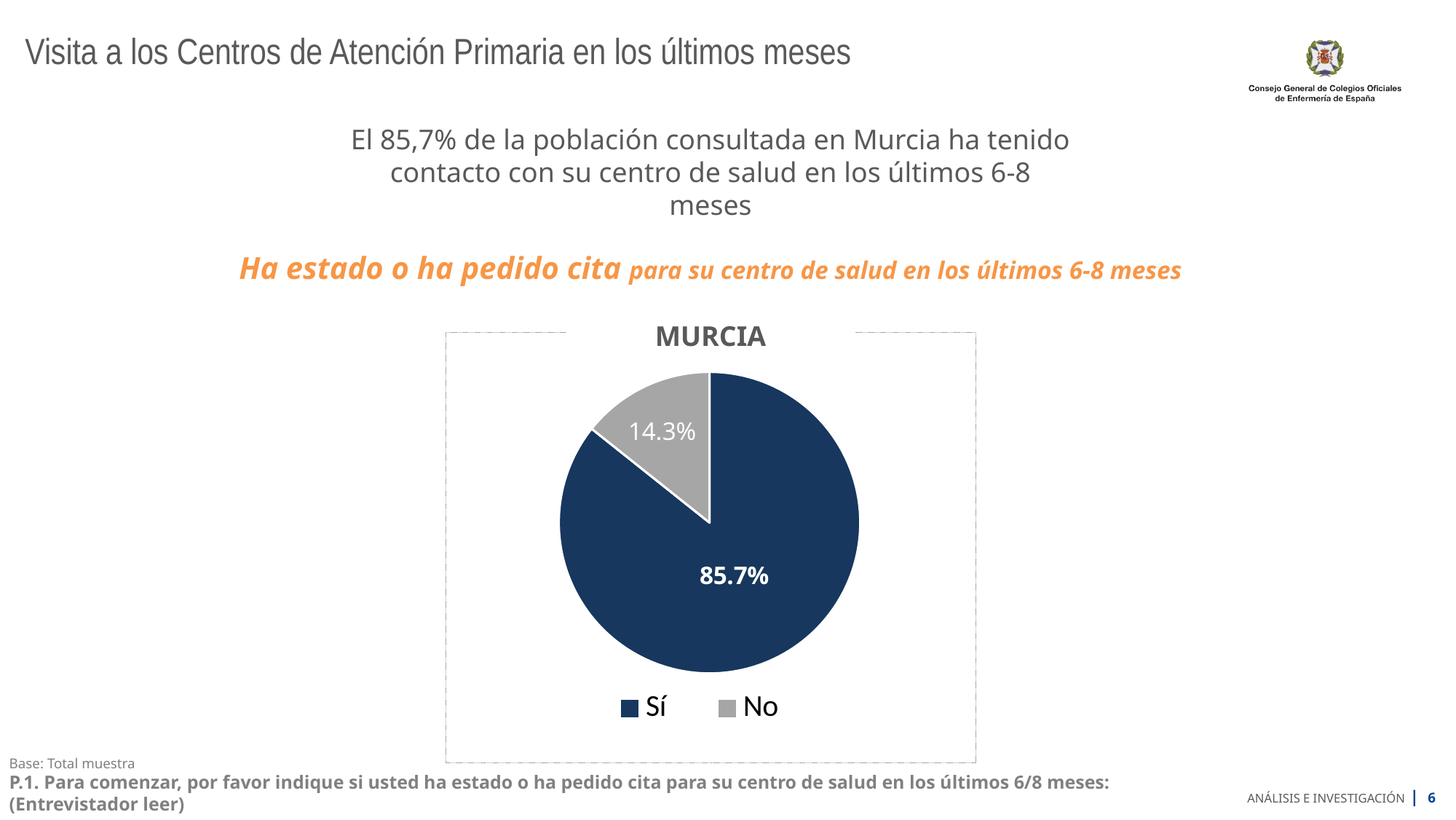
Which slice of the pie is the largest? Sí What is the difference in percentage points between the "Sí" and "No" slices? 71.4 What kind of chart is shown on the slide? Pie chart What colour is the "No" slice in the pie chart? Grey What percentage of the pie corresponds to "Sí"? 85.7% Which is larger, the "Sí" slice or the "No" slice? Sí What is the total of the two slices shown in the pie chart? 100% How many slices does the pie chart have? 2 What percentage of the pie corresponds to "No"? 14.3% What is the title of the chart? MURCIA How many entries does the legend list? 2 Which slice of the pie is the smallest? No